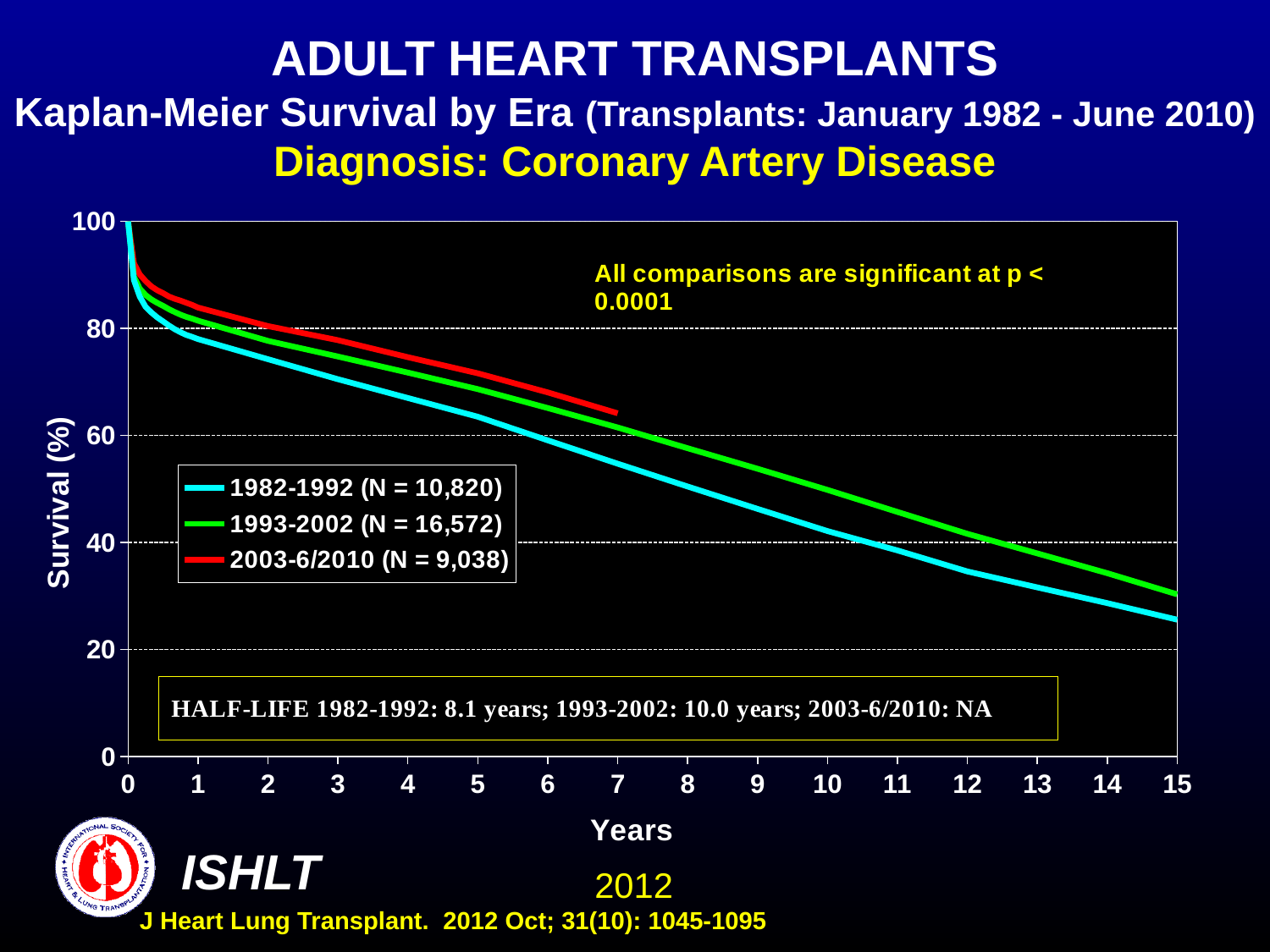
Which era has the highest survival at 3 years? 2003-6/2010 Do the survival values rise or fall as years increase along the x axis? fall Is the survival value for the 1993-2002 era at 15 years greater or less than 40? less At 5 years, which era has higher survival: 1982-1992 or 2003-6/2010? 2003-6/2010 Is the survival value for the 2003-6/2010 era at 7 years greater or less than 60? greater Which era has the lowest survival at 10 years? 1982-1992 What is the half-life stated for the 1993-2002 era? 10.0 years Is the survival value for the 1982-1992 era at 15 years greater or less than 40? less How many series does the legend list? 3 What kind of chart is shown on the slide? line chart Which era does the red line represent? 2003-6/2010 (N = 9,038)